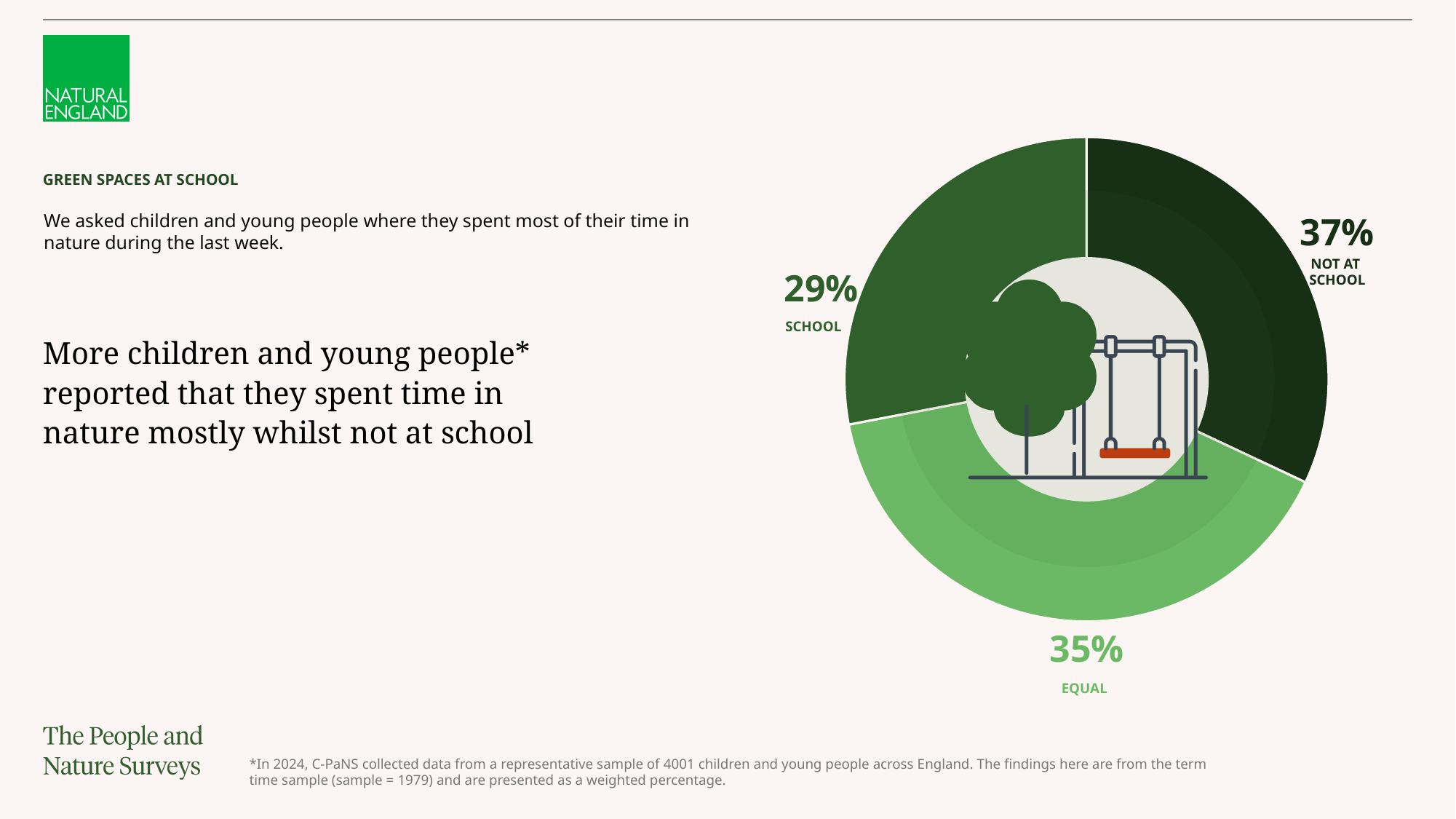
What is the heading of the section containing the chart? GREEN SPACES AT SCHOOL What percentage of children and young people reported spending most of their time in nature at school? 29% What kind of chart is shown on the slide? Pie chart (donut chart) What is the difference in percentage points between the 'Equal' and 'School' shares? 6 percentage points What percentage of children and young people reported spending most of their time in nature while not at school? 37% Which category has the largest share in the chart? Not at school What is the difference in percentage points between the 'Not at school' and 'School' shares? 8 percentage points How many categories are shown in the chart? 3 Which is larger, the share for 'Equal' or the share for 'School'? Equal Which category has the smallest share in the chart? School What is the combined share of the 'School' and 'Equal' categories? 64% What percentage of children and young people reported spending an equal amount of time in nature at school and not at school? 35%